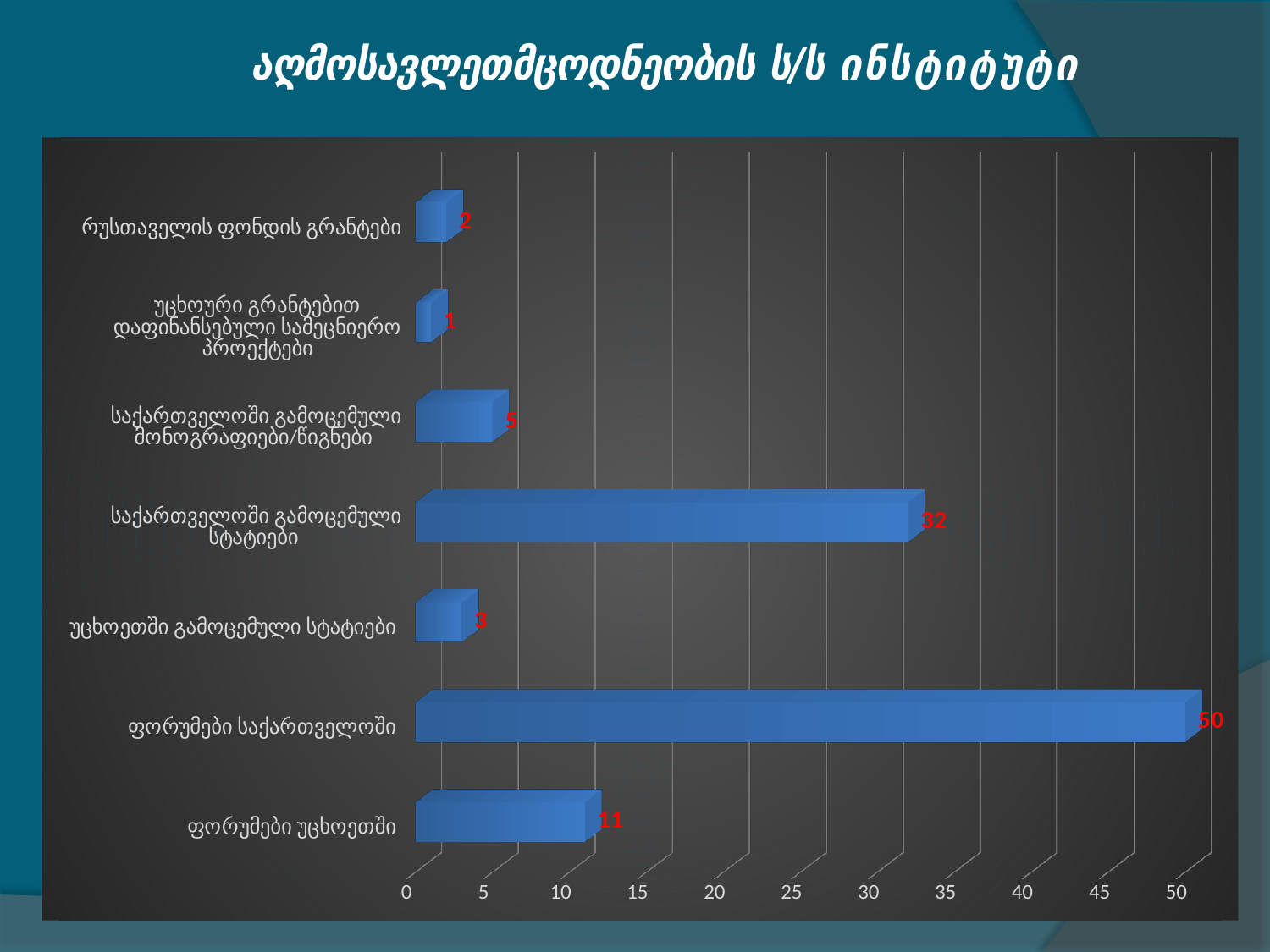
Which category has the lowest value? უცხოური გრანტებით დაფინანსებული სამეცნიერო პროექტები What is the value for რუსთაველის ფონდის გრანტები? 2 What is the value for ფორუმები უცხოეთში? 11 Which is larger: საქართველოში გამოცემული სტატიები or უცხოეთში გამოცემული სტატიები? საქართველოში გამოცემული სტატიები How many categories are shown in the chart? 7 What is the title of the slide? აღმოსავლეთმცოდნეობის ს/ს ინსტიტუტი What is the value for საქართველოში გამოცემული სტატიები? 32 Which category has the highest value? ფორუმები საქართველოში Is the value for საქართველოში გამოცემული სტატიები greater or less than 30? greater What kind of chart is shown on the slide? bar chart What is the difference between the values for ფორუმები საქართველოში and ფორუმები უცხოეთში? 39 What is the value for ფორუმები საქართველოში? 50